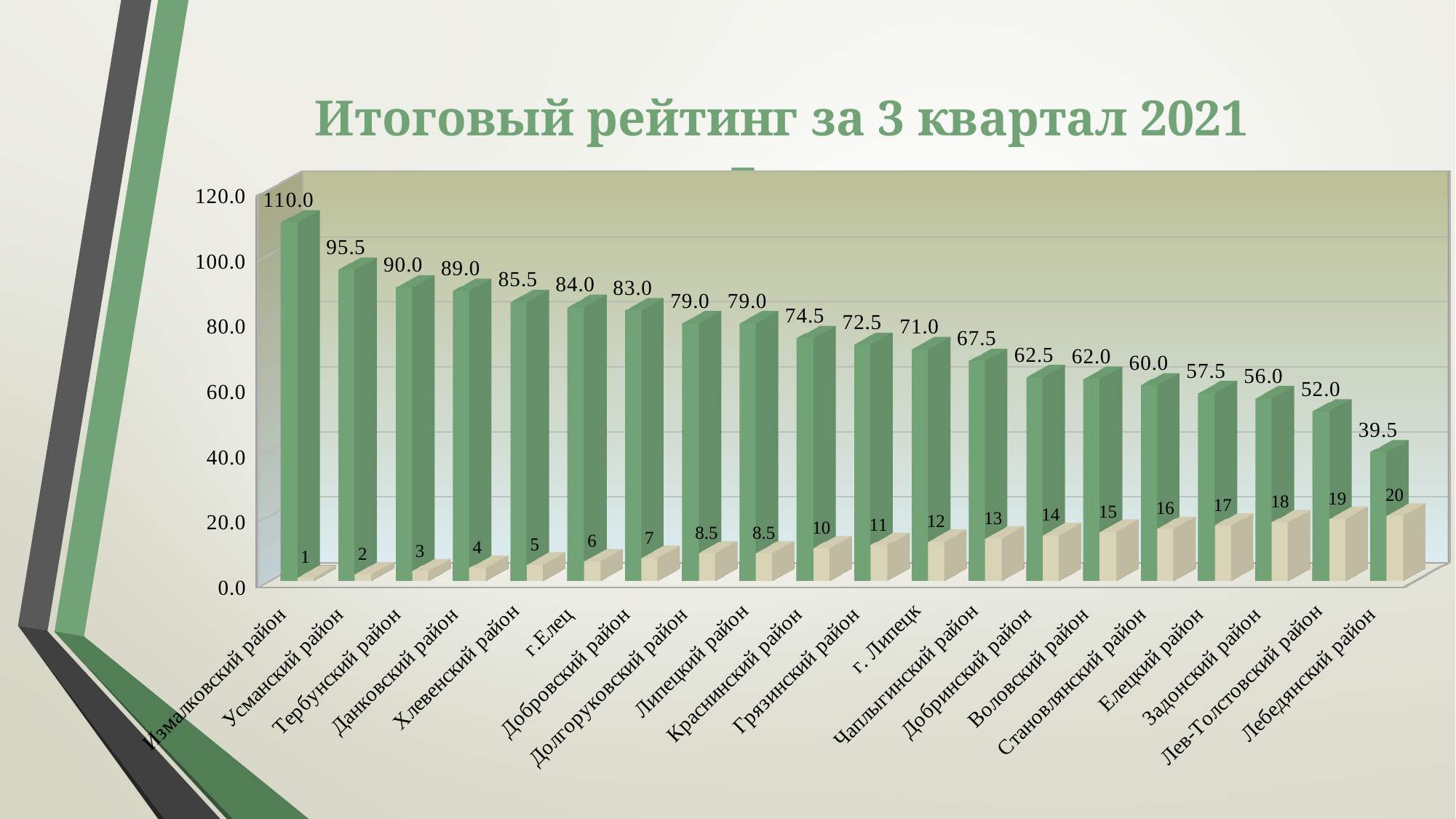
What is the difference between the rating values of Измалковский район and Лебедянский район? 70.5 What is the title of the chart? Итоговый рейтинг за 3 квартал 2021 Is the rating value for Хлевенский район greater or less than 80.0? greater Which category has the highest rating value? Измалковский район What kind of chart is shown on the slide? Bar chart What is the difference between the rating values of Тербунский район and Данковский район? 1.0 What is the rating value shown for г. Липецк? 71.0 Which has a higher rating value, Добровский район or Чаплыгинский район? Добровский район How many categories (districts/cities) are shown on the chart? 20 What rank number is shown for Краснинский район? 10 Which category has the lowest rating value? Лебедянский район What is the rating value shown for Усманский район? 95.5